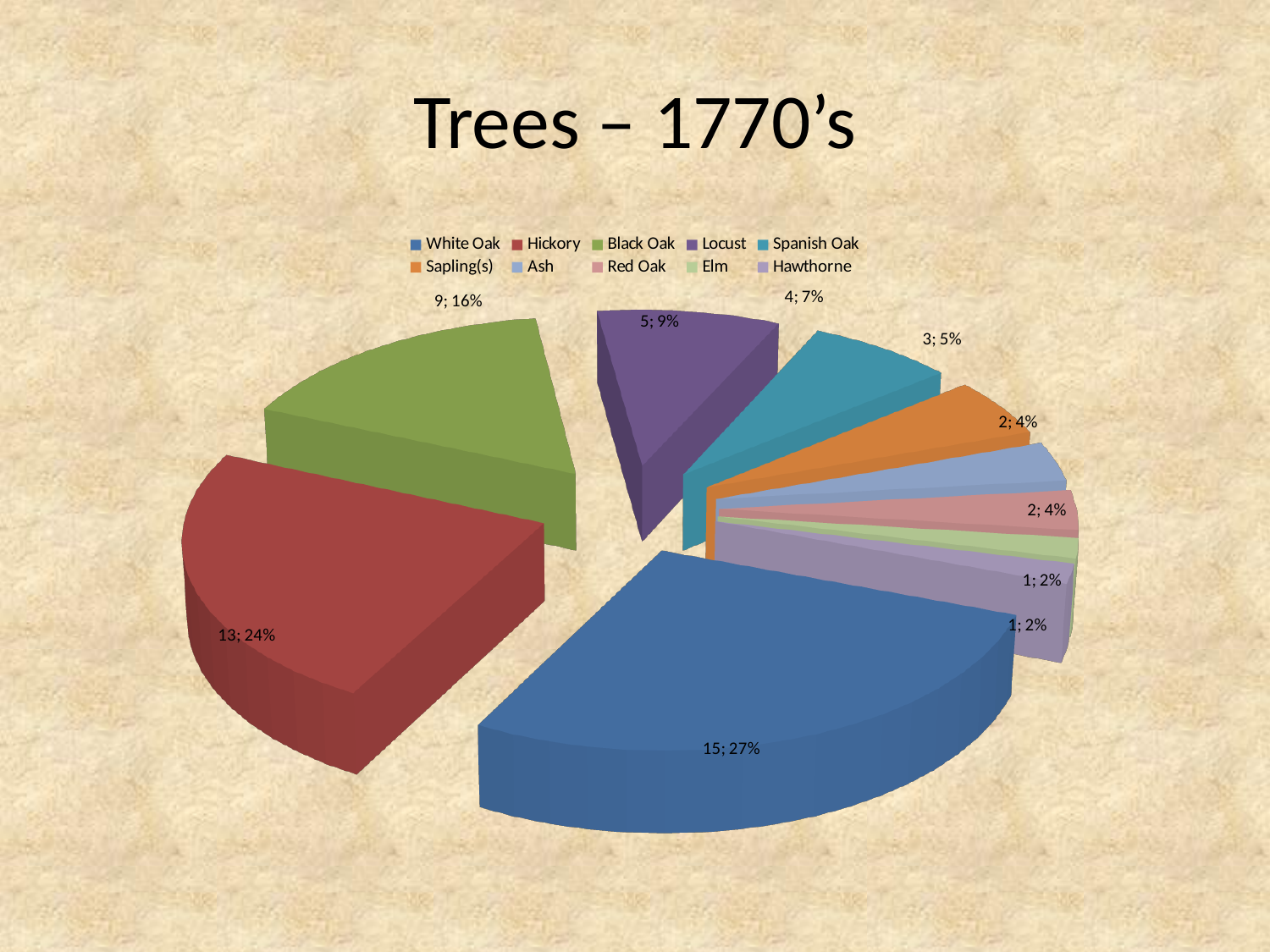
What percentage share does Black Oak have? 16% Which tree category has the largest slice? White Oak Which is larger, the Black Oak slice or the Locust slice? Black Oak What is the title of the chart? Trees – 1770's What percentage share does Locust have? 9% What is the difference in count between Black Oak and Locust? 4 What count and share are shown for Hickory? 13; 24% What count and share are shown for White Oak? 15; 27% What is the difference in count between White Oak and Hickory? 2 How many tree categories does the legend list? 10 What kind of chart is shown on the slide? pie chart What colour is the White Oak slice? blue